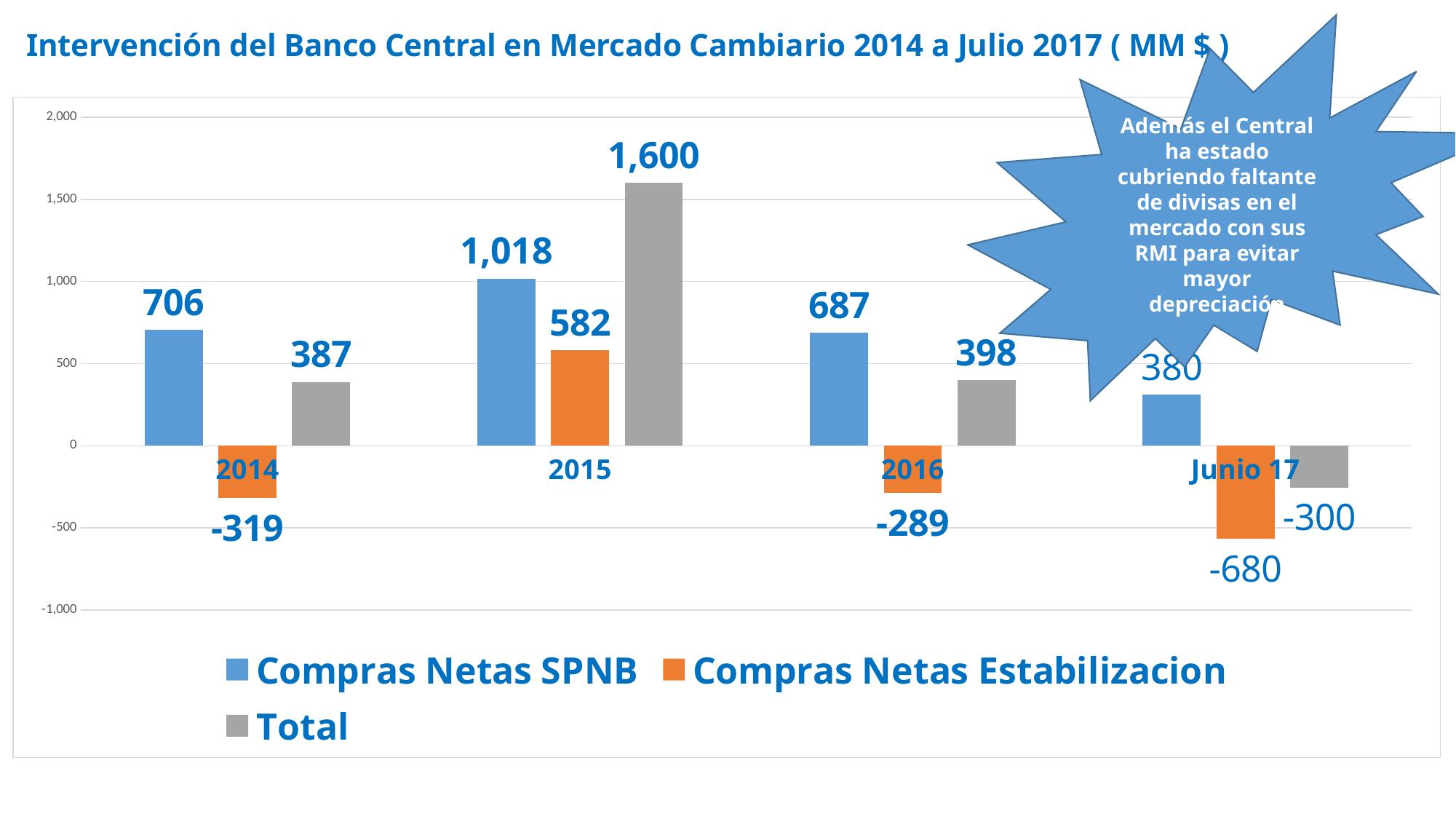
Which series is shown in orange? Compras Netas Estabilizacion Which category has the lowest value for Compras Netas Estabilizacion? Junio 17 What is the difference between the Compras Netas SPNB values for 2015 and 2014? 312 Which year has the highest Total value? 2015 What is the Total value for 2016? 398 How many categories are shown on the x axis? 4 Which is larger, the Total for 2014 or the Total for 2016? Total for 2016 How many series does the legend list? 3 What is the value of Compras Netas Estabilizacion for 2014? -319 What is the value of Compras Netas SPNB for 2015? 1,018 What kind of chart is shown on the slide? Bar chart What is the value of Compras Netas Estabilizacion for Junio 17? -680